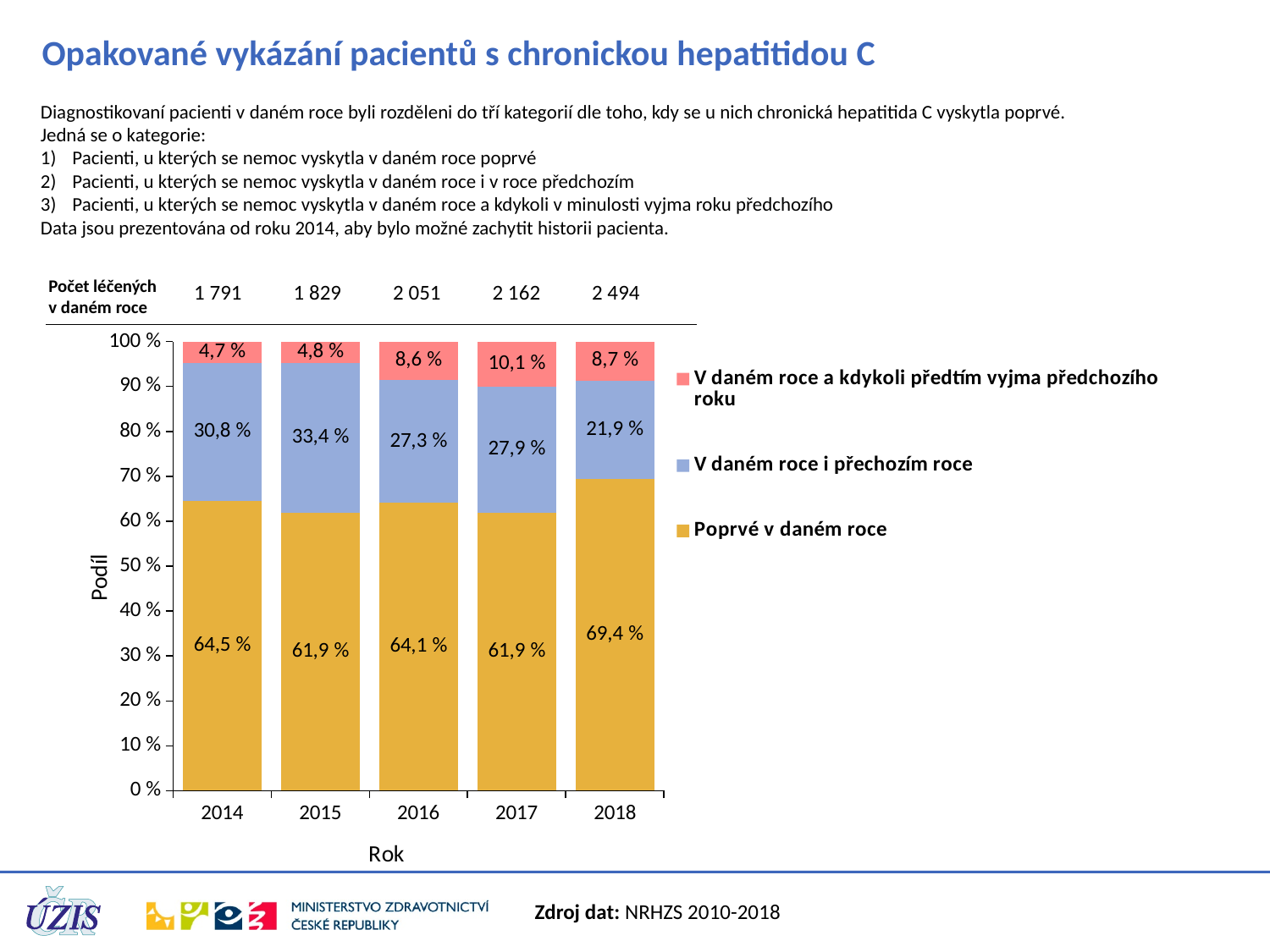
What is the share for 'V daném roce i přechozím roce' in 2015? 33,4 % Does the share for 'V daném roce i přechozím roce' rise or fall from 2015 to 2018? Fall In which year is the share for 'V daném roce a kdykoli předtím vyjma předchozího roku' the lowest? 2014 What is the share for 'V daném roce a kdykoli předtím vyjma předchozího roku' in 2017? 10,1 % What is the share for 'Poprvé v daném roce' in 2018? 69,4 % By how many percentage points does the 'Poprvé v daném roce' share in 2018 exceed that in 2017? 7,5 % How many series does the chart legend list? 3 Which year has the larger share for 'V daném roce i přechozím roce', 2016 or 2017? 2017 In which year is the share for 'Poprvé v daném roce' the highest? 2018 What kind of chart is shown on the slide? Stacked bar chart How many years are shown on the x axis of the chart? 5 What is the 'Počet léčených v daném roce' value shown above the bar for 2016? 2 051